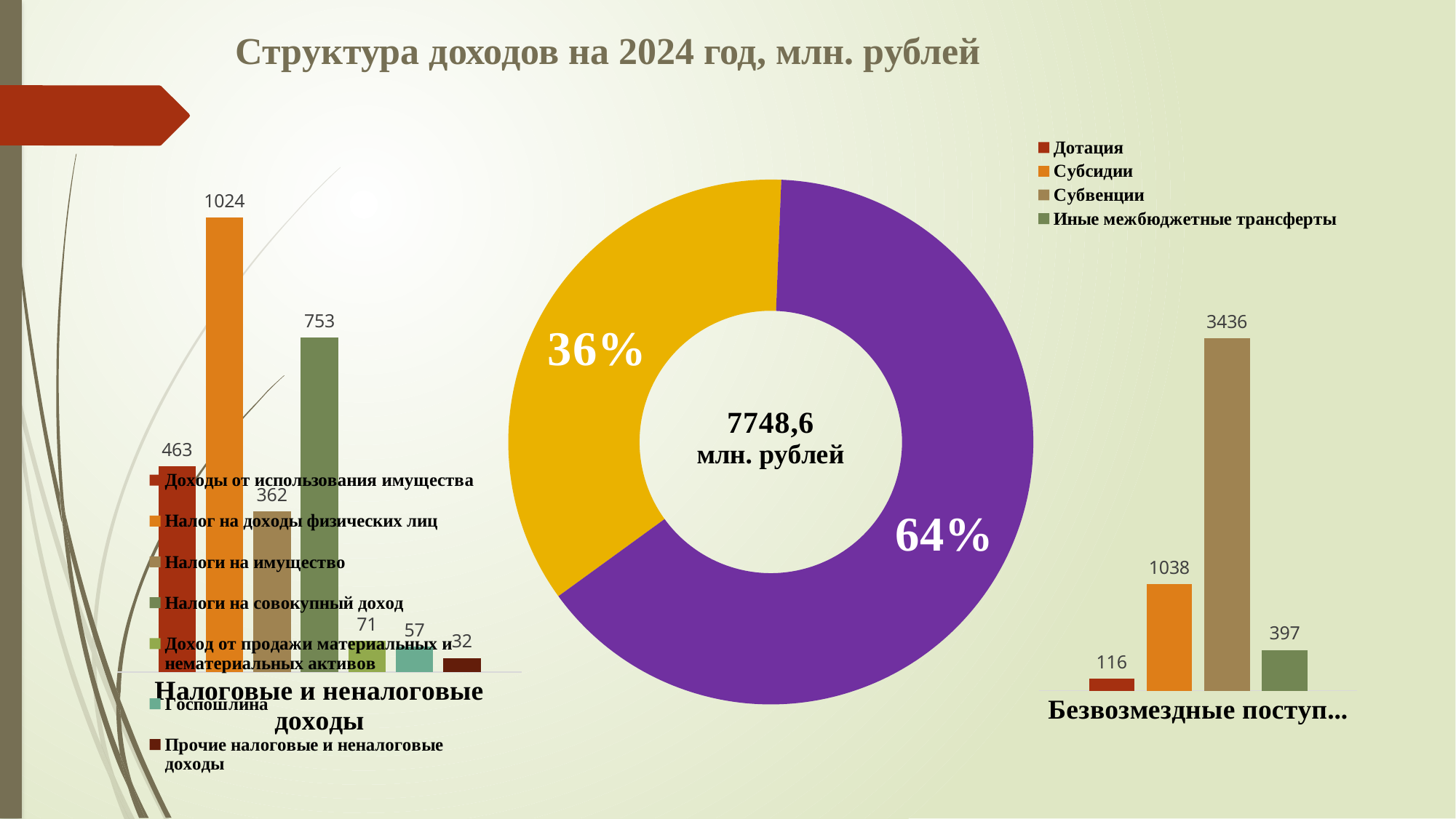
In the left bar chart (Налоговые и неналоговые доходы), which category has the highest value? Налог на доходы физических лиц In the right bar chart (Безвозмездные поступ...), what is the value for Дотация? 116 In the left bar chart (Налоговые и неналоговые доходы), which category has the lowest value? Прочие налоговые и неналоговые доходы In the right bar chart (Безвозмездные поступ...), what is the value for Субвенции? 3436 In the middle donut chart, what share does the purple slice represent? 64% In the left bar chart (Налоговые и неналоговые доходы), how many series does the legend list? 7 What total value is shown in the centre of the middle donut chart? 7748,6 млн. рублей In the left bar chart (Налоговые и неналоговые доходы), what is the value for Налог на доходы физических лиц? 1024 In the right bar chart (Безвозмездные поступ...), how many series does the legend list? 4 In the left bar chart (Налоговые и неналоговые доходы), what is the difference between Налоги на совокупный доход and Налоги на имущество? 391 In the right bar chart (Безвозмездные поступ...), what is the difference between Субвенции and Субсидии? 2398 In the right bar chart (Безвозмездные поступ...), which is larger: Субсидии or Иные межбюджетные трансферты? Субсидии